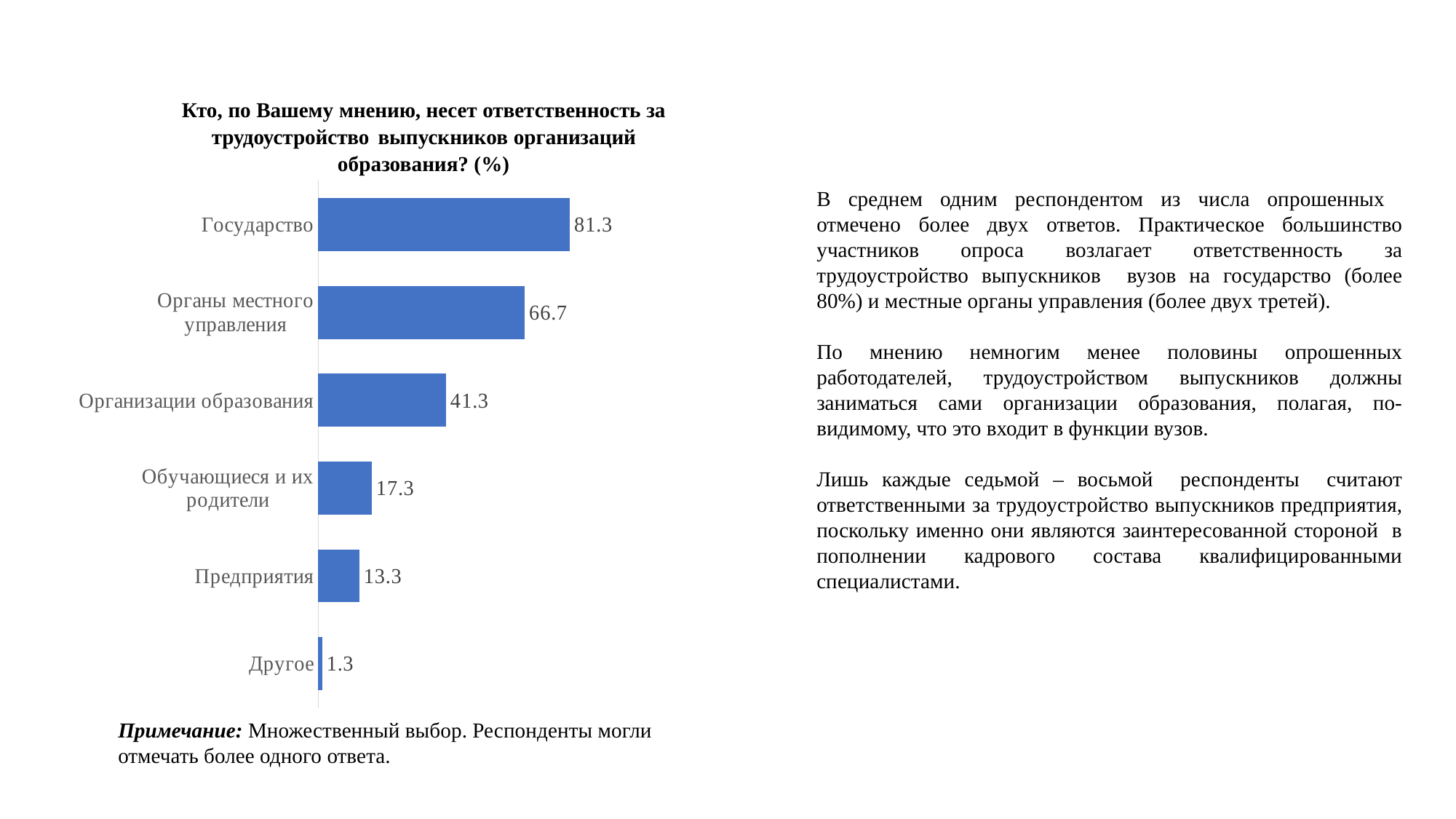
What colour are the bars in the chart? Blue What kind of chart is shown on the slide? Bar chart What is the difference between the values for Государство and Органы местного управления? 14.6 What is the value for Организации образования? 41.3 How many categories are shown in the chart? 6 Which category has the highest value? Государство What is the difference between the values for Обучающиеся и их родители and Предприятия? 4.0 What is the value for Предприятия? 13.3 Which category has the lowest value? Другое What is the value for Государство? 81.3 Which is larger, the value for Организации образования or the value for Обучающиеся и их родители? Организации образования What is the value for Органы местного управления? 66.7